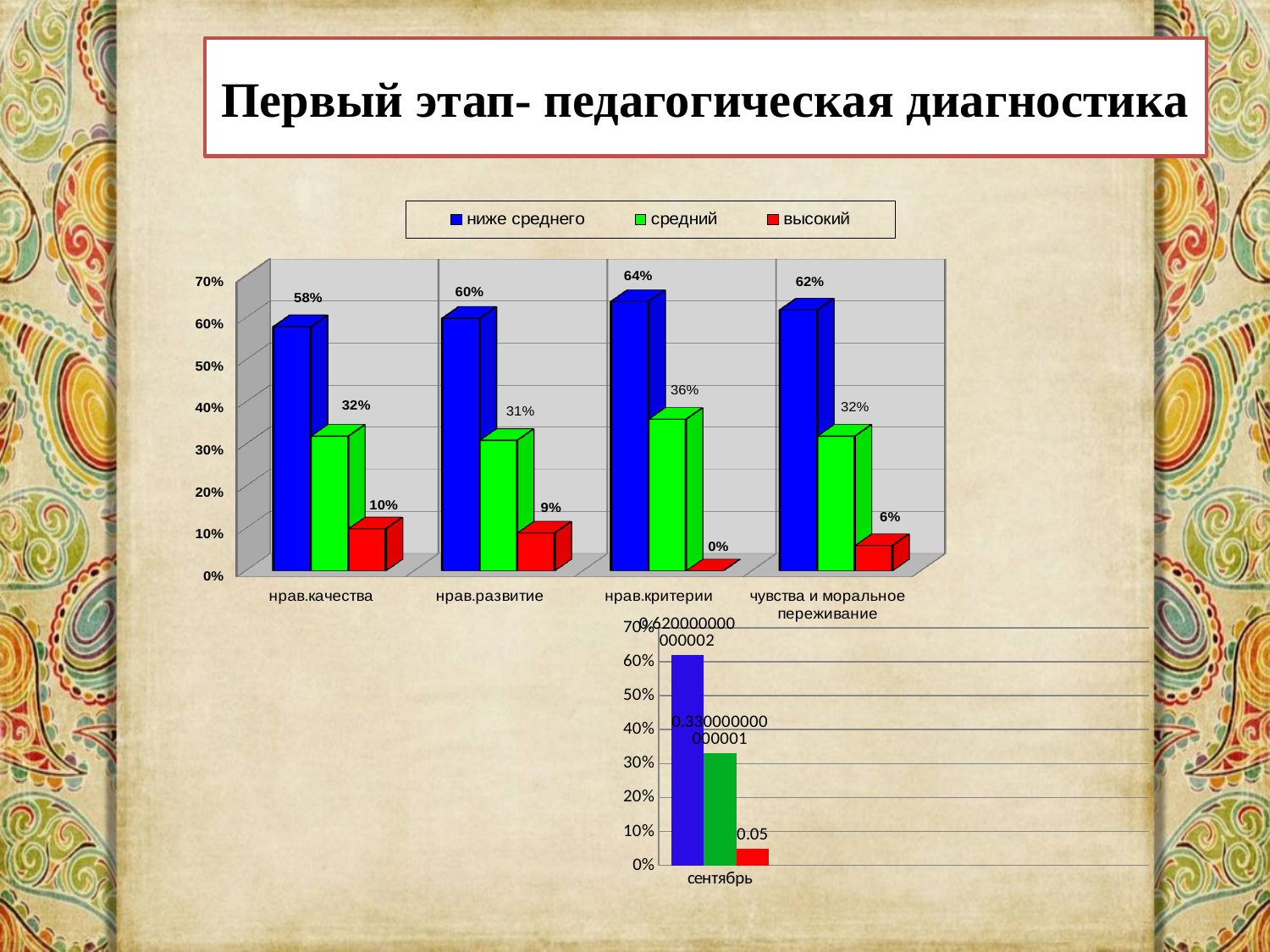
In the upper chart, which category has the lowest 'высокий' value? нрав.критерии In the upper chart, what is the value of 'ниже среднего' for 'нрав.критерии'? 64% How many series does the legend of the upper chart list? 3 In the lower chart, what value is labelled on the red bar? 0.05 What kind of chart is the upper chart on the slide? bar chart In the upper chart, what is the value of 'высокий' for 'нрав.развитие'? 9% What is the category label shown on the x axis of the lower chart? сентябрь In the upper chart, what is the difference between the 'средний' values for 'нрав.критерии' and 'нрав.качества'? 4% In the upper chart, is the 'средний' value for 'нрав.развитие' greater or less than 40%? less How many categories are shown along the x axis of the upper chart? 4 In the upper chart, which has the larger 'ниже среднего' value: 'нрав.качества' or 'чувства и моральное переживание'? чувства и моральное переживание In the upper chart, which category has the highest 'ниже среднего' value? нрав.критерии